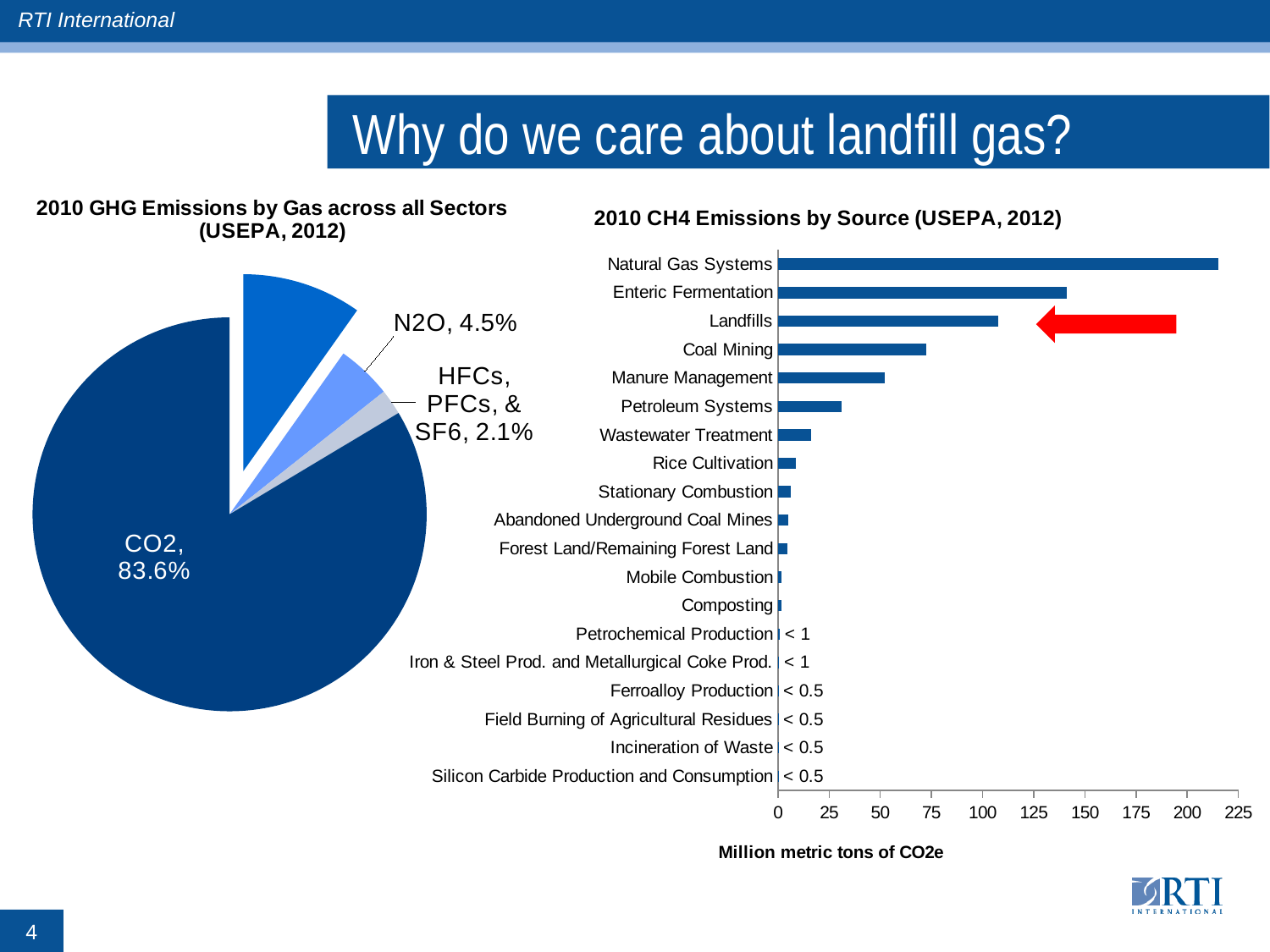
In the bar chart '2010 CH4 Emissions by Source', what unit is shown on the x axis? Million metric tons of CO2e What kind of chart is '2010 CH4 Emissions by Source (USEPA, 2012)'? bar chart What kind of chart is '2010 GHG Emissions by Gas across all Sectors'? pie chart In the bar chart '2010 CH4 Emissions by Source', is the value for Natural Gas Systems greater or less than 200? greater In the pie chart '2010 GHG Emissions by Gas across all Sectors', what share is attributed to HFCs, PFCs, & SF6? 2.1% In the pie chart '2010 GHG Emissions by Gas across all Sectors', what share of emissions is N2O? 4.5% How many sources are listed in the bar chart '2010 CH4 Emissions by Source'? 19 In the pie chart '2010 GHG Emissions by Gas across all Sectors', what share of emissions is CO2? 83.6% In the bar chart '2010 CH4 Emissions by Source', is the value for Landfills greater or less than 100? greater In the bar chart '2010 CH4 Emissions by Source', which source has the highest emissions? Natural Gas Systems In the bar chart '2010 CH4 Emissions by Source', which is larger, Landfills or Coal Mining? Landfills